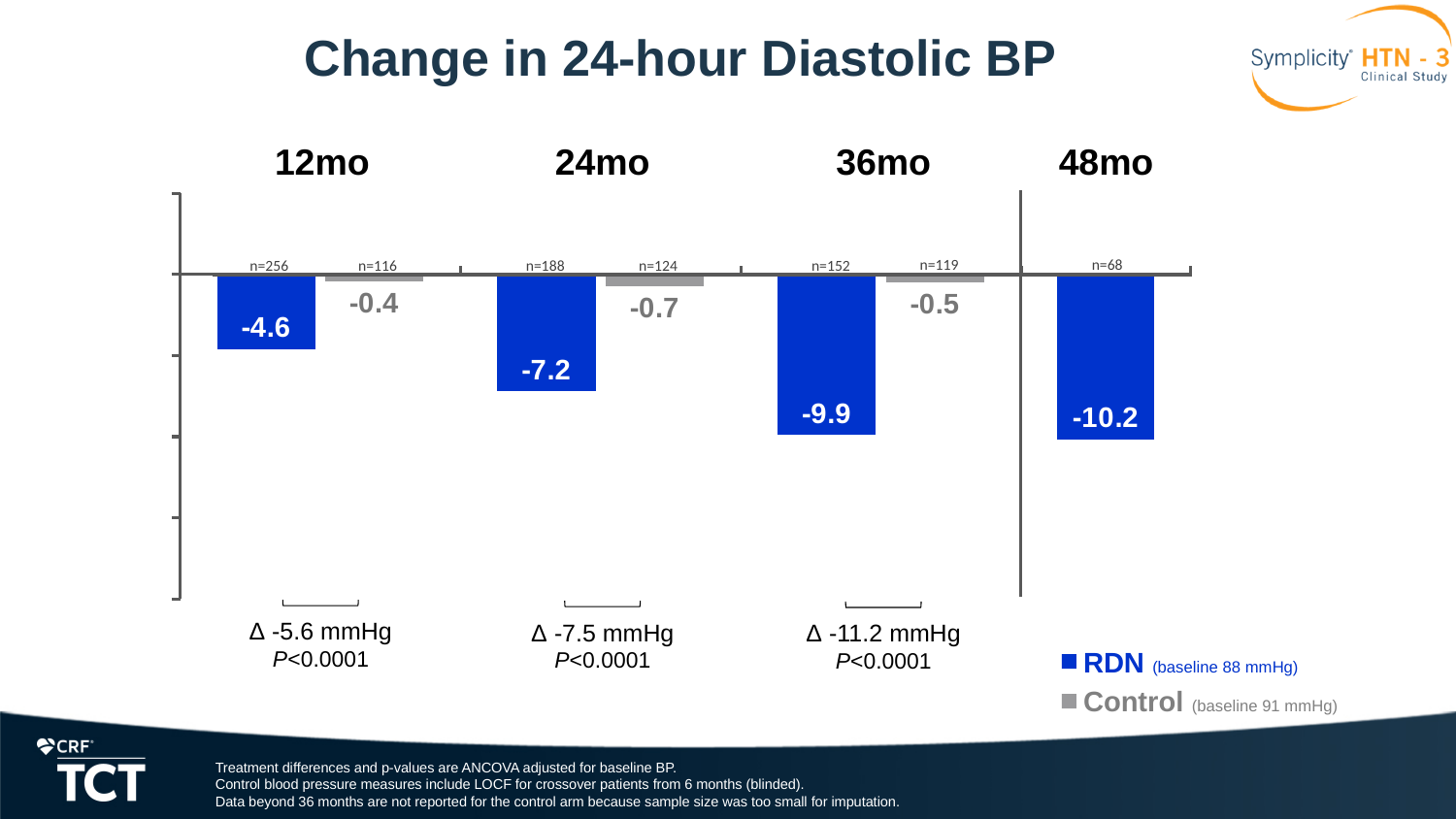
How many time points are shown on the x axis of the chart? 4 How many series does the legend list? 2 What is the change in 24-hour diastolic BP for the Control group at 24 months? -0.7 What kind of chart is shown on the slide? Bar chart What is the change in 24-hour diastolic BP for the RDN group at 12 months? -4.6 At which time point does the RDN group show the largest reduction in 24-hour diastolic BP? 48mo What is the change in 24-hour diastolic BP for the RDN group at 48 months? -10.2 At which time point does the RDN group show the smallest reduction in 24-hour diastolic BP? 12mo Which group shows a larger reduction in 24-hour diastolic BP at 24 months, RDN or Control? RDN Does the RDN group's change in 24-hour diastolic BP become more negative or less negative from 12 months to 48 months? More negative What is the change in 24-hour diastolic BP for the Control group at 36 months? -0.5 What is the treatment difference (Δ) between RDN and Control shown at 36 months? -11.2 mmHg